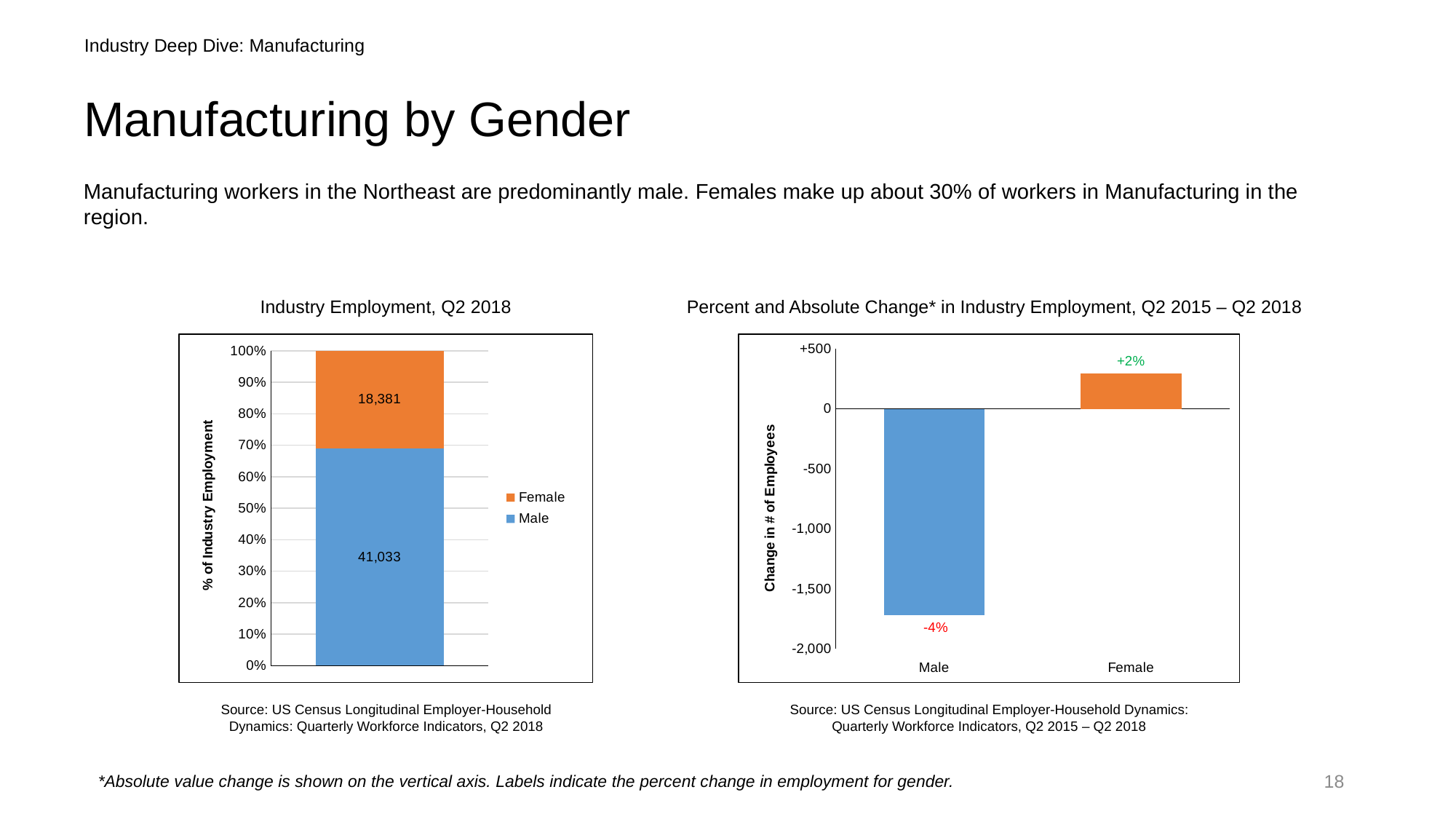
In the 'Percent and Absolute Change in Industry Employment, Q2 2015 – Q2 2018' chart, what percent change label is shown for Female? +2% In the 'Industry Employment, Q2 2018' chart, which gender has the larger number of employees? Male In the 'Industry Employment, Q2 2018' chart, what is the value shown for Female? 18,381 In the 'Industry Employment, Q2 2018' chart, what is the total of the stacked bar? 59,414 In the 'Industry Employment, Q2 2018' chart, what is the value shown for Male? 41,033 In the 'Percent and Absolute Change in Industry Employment, Q2 2015 – Q2 2018' chart, what percent change label is shown for Male? -4% In the 'Industry Employment, Q2 2018' chart, what is the difference between the Male and Female values? 22,652 In the 'Percent and Absolute Change in Industry Employment, Q2 2015 – Q2 2018' chart, is the change in number of employees for Male greater or less than -1,500? less In the 'Percent and Absolute Change in Industry Employment, Q2 2015 – Q2 2018' chart, which gender shows a decrease in employment? Male What type of chart is the 'Industry Employment, Q2 2018' chart? Stacked bar chart How many categories are shown on the x axis of the 'Percent and Absolute Change in Industry Employment, Q2 2015 – Q2 2018' chart? 2 How many series does the legend of the 'Industry Employment, Q2 2018' chart list? 2